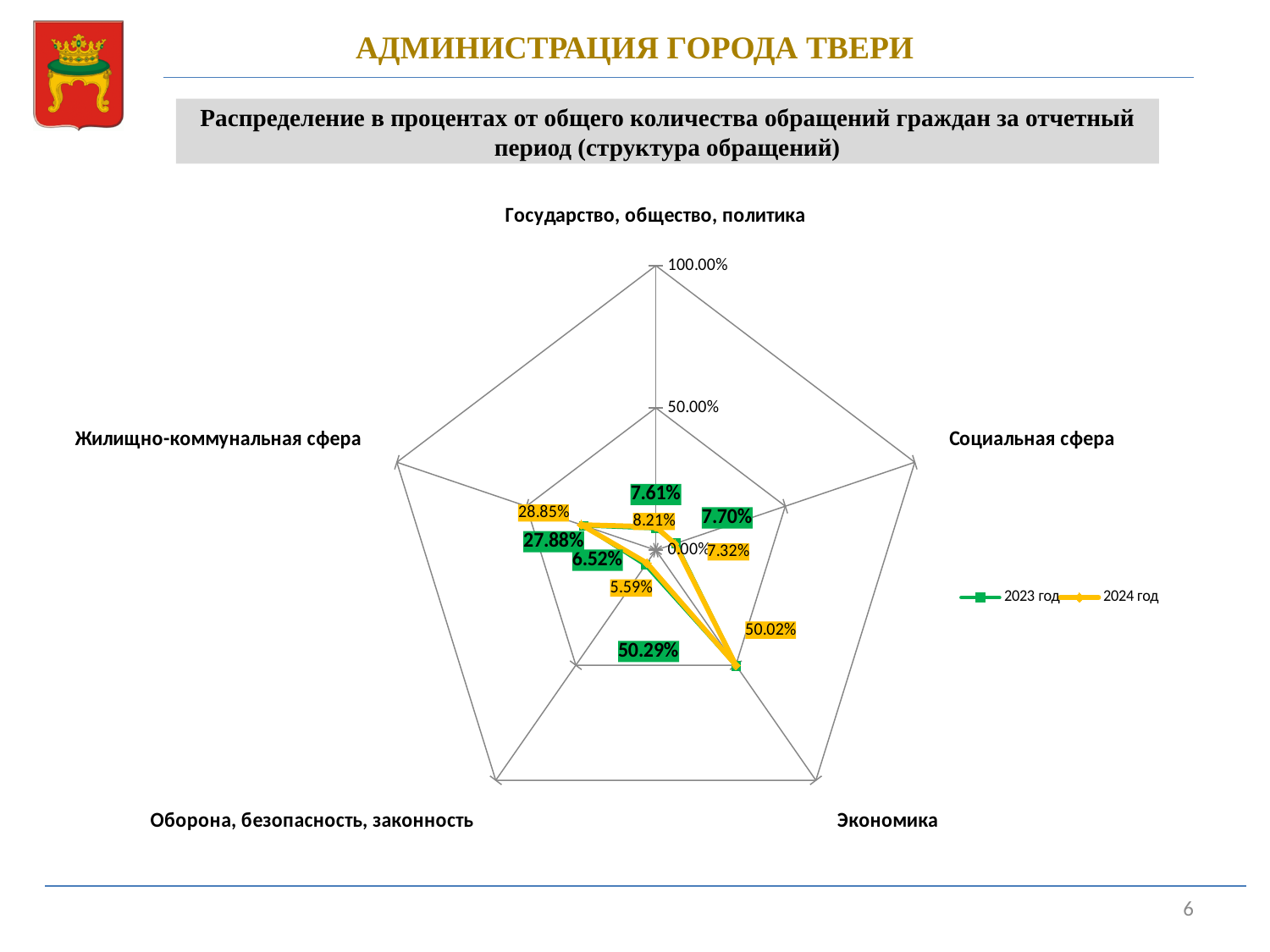
Which series is drawn in yellow? 2024 год What is the value for Экономика in the 2023 год series? 50.29% What is the value for Жилищно-коммунальная сфера in the 2024 год series? 28.85% Is the 2023 год value for Экономика greater or less than 50.00%? greater What is the value for Оборона, безопасность, законность in the 2024 год series? 5.59% What type of chart is shown on the slide? Radar chart Which category has the highest value in the 2024 год series? Экономика How many series does the legend list? 2 What is the value for Государство, общество, политика in the 2023 год series? 7.61% What is the difference between the 2024 год and 2023 год values for Жилищно-коммунальная сфера? 0.97% Which category has the lowest value in the 2024 год series? Оборона, безопасность, законность How many categories (axes) does the radar chart have? 5